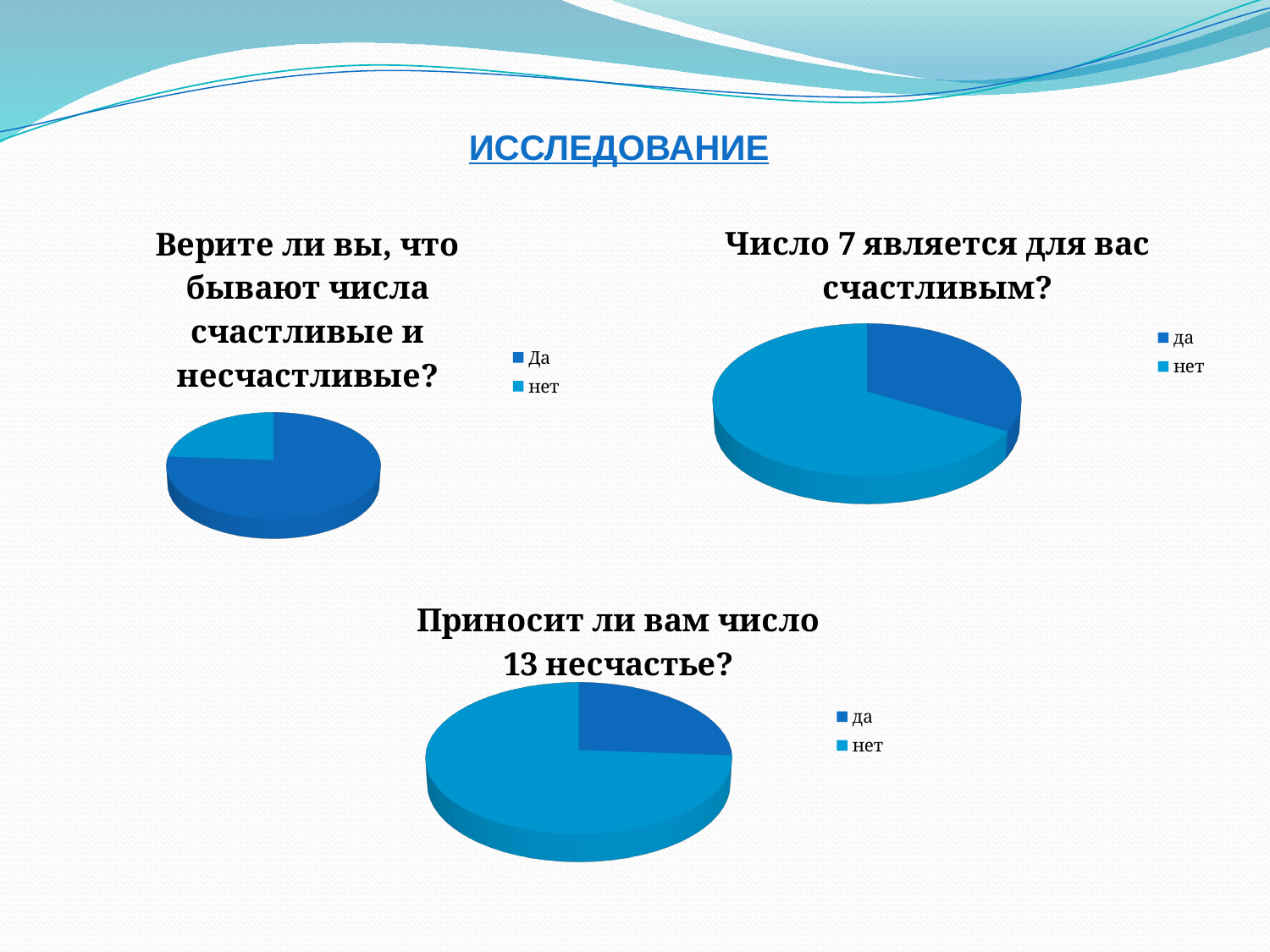
How many entries does the legend of the chart "Приносит ли вам число 13 несчастье?" list? 2 In the chart "Приносит ли вам число 13 несчастье?", which slice is the smallest? да What are the legend entries of the chart "Число 7 является для вас счастливым?"? да, нет What is the title of the chart at the bottom of the slide? Приносит ли вам число 13 несчастье? How many charts are on the slide? 3 In the chart "Число 7 является для вас счастливым?", which slice is the largest? нет In the chart "Число 7 является для вас счастливым?", which is larger, да or нет? нет In the chart "Верите ли вы, что бывают числа счастливые и несчастливые?", which slice is the smallest? нет What kind of chart is used for "Верите ли вы, что бывают числа счастливые и несчастливые?"? Pie chart In the chart "Верите ли вы, что бывают числа счастливые и несчастливые?", which slice is the largest? Да In the chart "Приносит ли вам число 13 несчастье?", which is larger, да or нет? нет How many slices does the chart "Число 7 является для вас счастливым?" have? 2